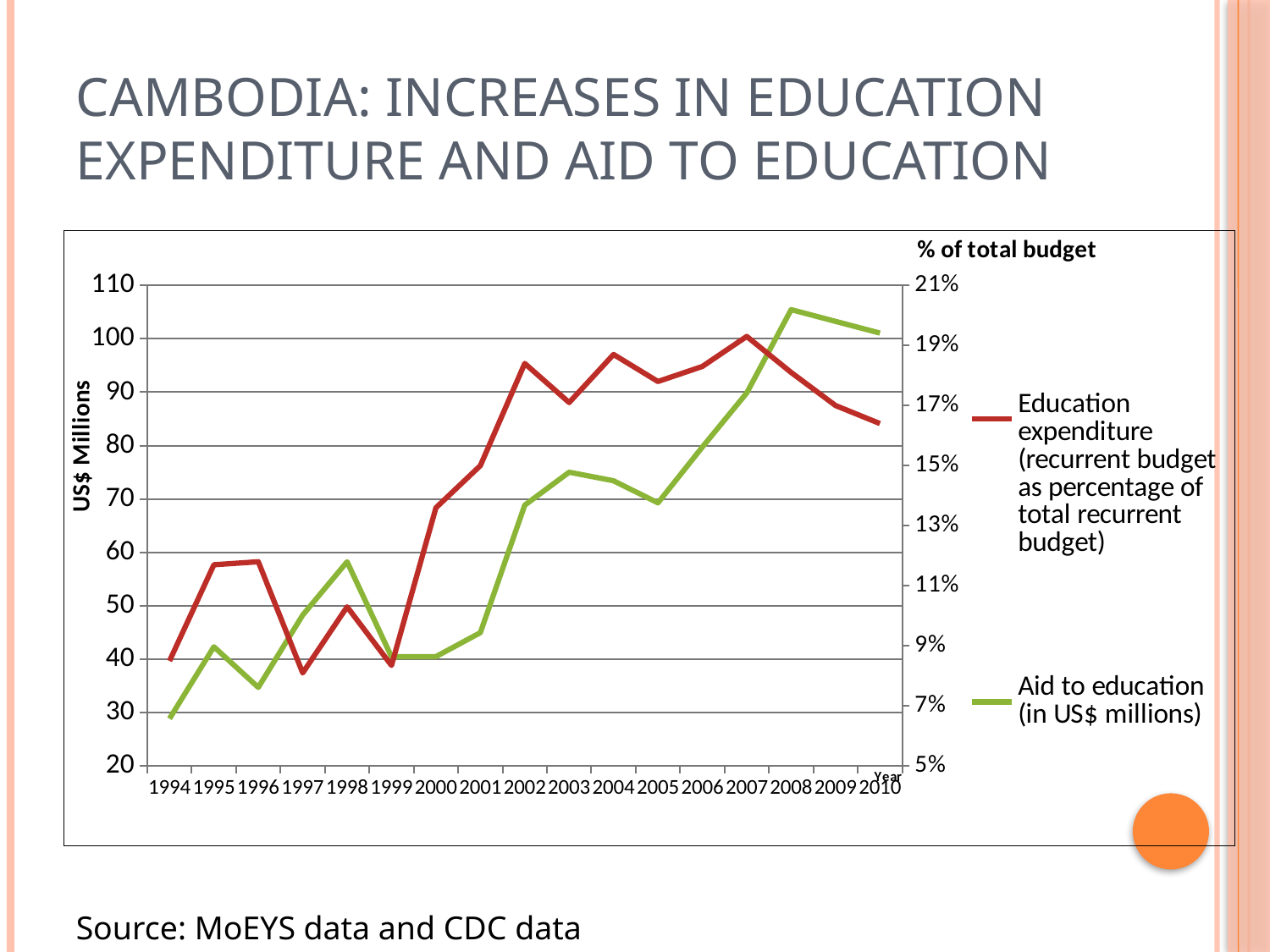
Is the value for Education expenditure in 2010 greater or less than 17%? less Is the value for Education expenditure in 1994 greater or less than 11%? less How many series does the legend list? 2 What is the label on the left vertical axis? US$ Millions In which year is Education expenditure (as percentage of total recurrent budget) highest? 2007 Does Aid to education rise or fall from 2005 to 2008? rise In which year is Aid to education (in US$ millions) lowest? 1994 Is the value for Aid to education in 2008 greater or less than 100 US$ millions? greater What kind of chart is shown on the slide? line chart How many years are plotted along the x axis? 17 In which year is Aid to education (in US$ millions) highest? 2008